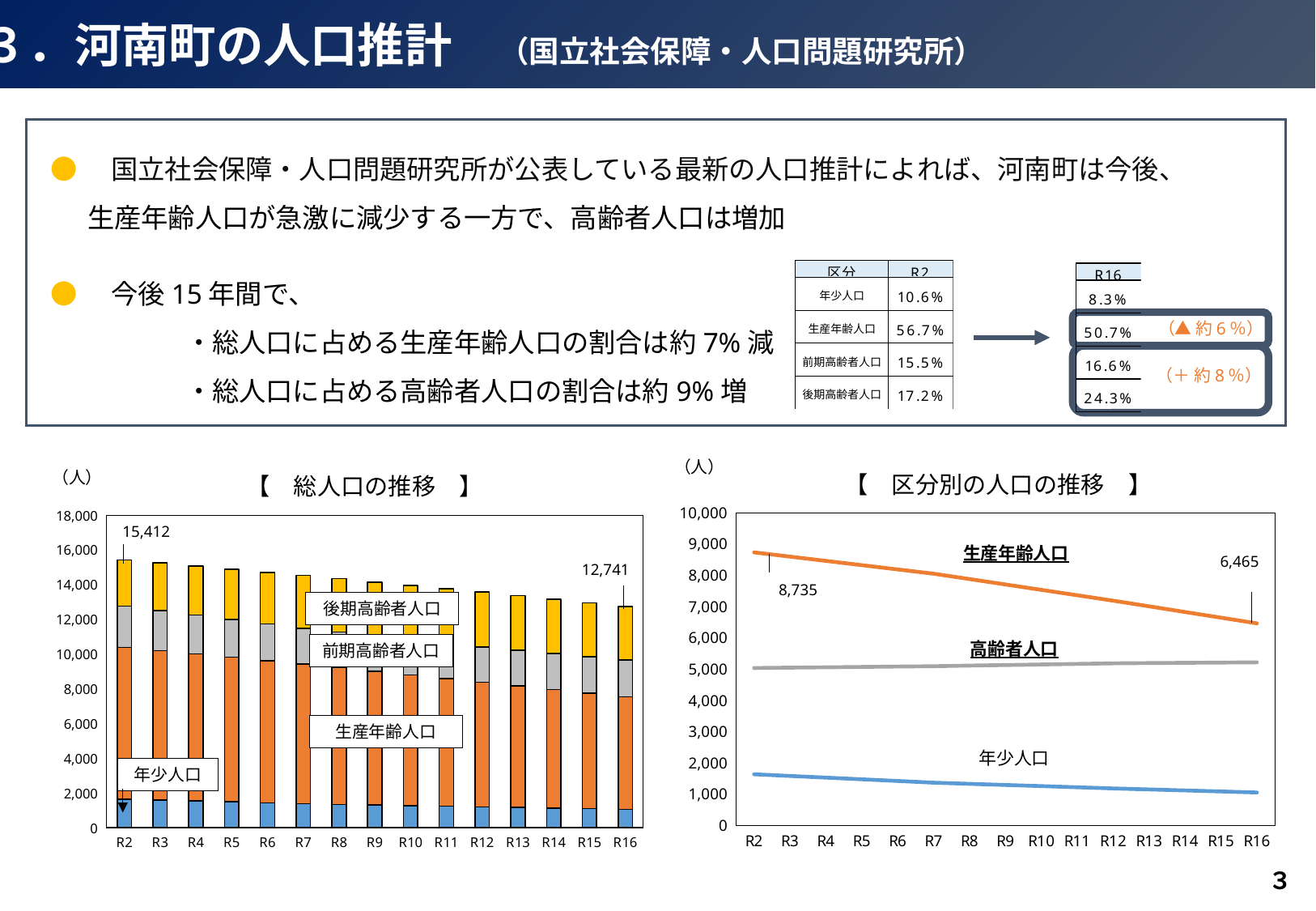
On the right chart (区分別の人口の推移), how many lines (series) are plotted? 3 On the right chart (区分別の人口の推移), what is the value of 生産年齢人口 at R2? 8,735 On the right chart (区分別の人口の推移), by how much does 生産年齢人口 decrease from R2 to R16? 2,270 On the left chart (総人口の推移), do the total bar heights rise or fall from R2 to R16? Fall On the right chart (区分別の人口の推移), is the value of 年少人口 at R16 greater or less than 2,000? less On the left chart (総人口の推移), how many population categories are stacked in each bar? 4 On the left chart (総人口の推移), what is the total population shown for R2? 15,412 On the right chart (区分別の人口の推移), what is the value of 生産年齢人口 at R16? 6,465 On the left chart (総人口の推移), what is the difference between the R2 total and the R16 total? 2,671 On the left chart (総人口の推移), what is the total population shown for R16? 12,741 On the left chart (総人口の推移), what kind of chart is used? Stacked bar chart On the left chart (総人口の推移), how many years (bars) are plotted? 15